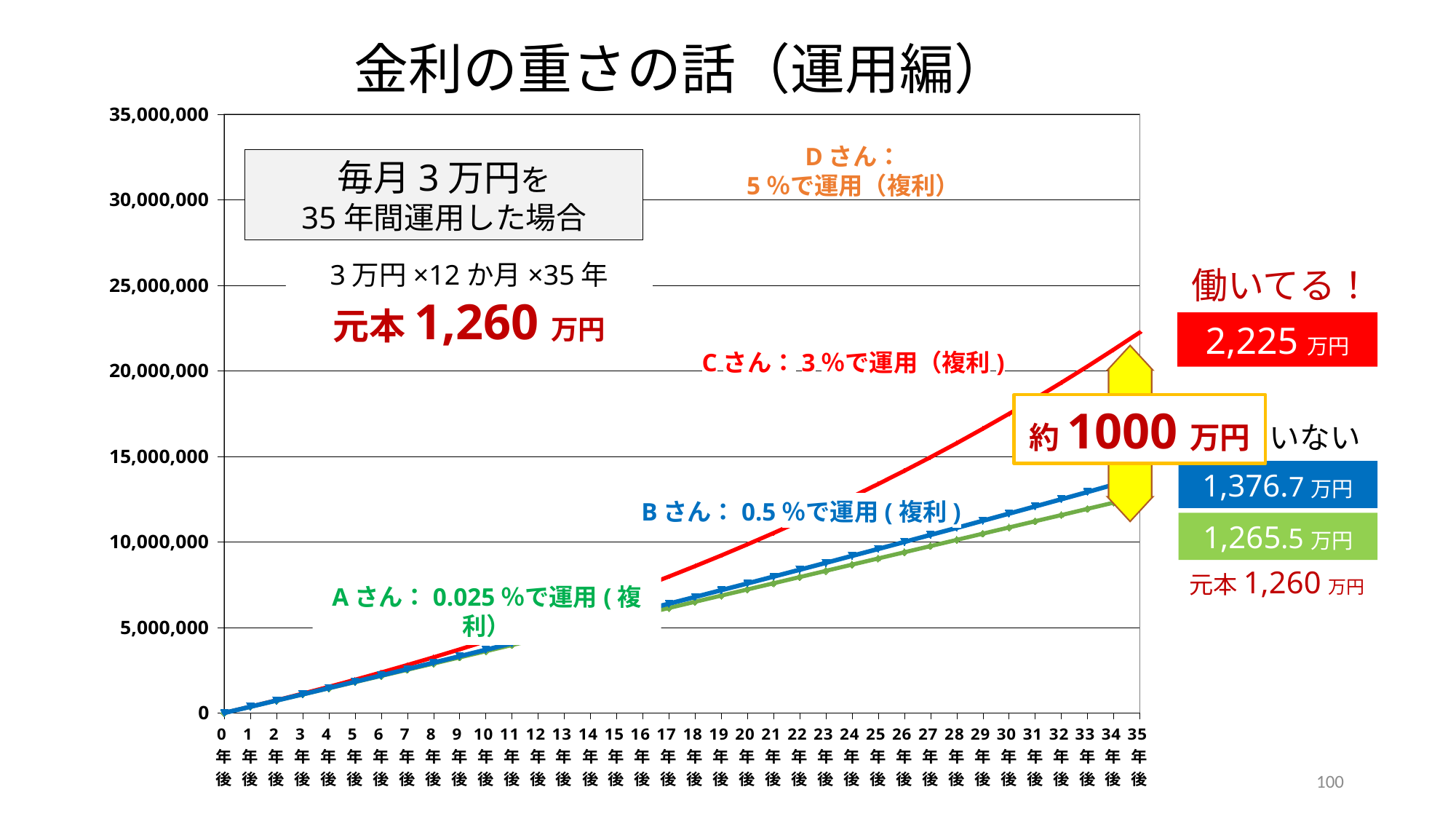
What is the difference between the final amounts shown for Bさん (1,376.7万円) and Aさん (1,265.5万円)? 111.2万円 At 35年後, which is larger: the red line (Cさん) or the blue line (Bさん)? red line (Cさん) Do the plotted lines rise or fall as the years increase along the x axis? rise What is the title of the slide chart? 金利の重さの話（運用編） Which person's line is the lowest at 35年後? Aさん What kind of chart is shown on the slide? line chart Which person's line is the highest at 35年後? Cさん What final amount is shown for Bさん (0.5% compound)? 1,376.7万円 How many points are on the x axis, from 0年後 to 35年後? 36 What final amount is shown for Cさん (3% compound)? 2,225万円 Is the value of the red line (Cさん) at 35年後 greater or less than 20,000,000? greater Is the value of the blue line (Bさん) at 35年後 greater or less than 15,000,000? less